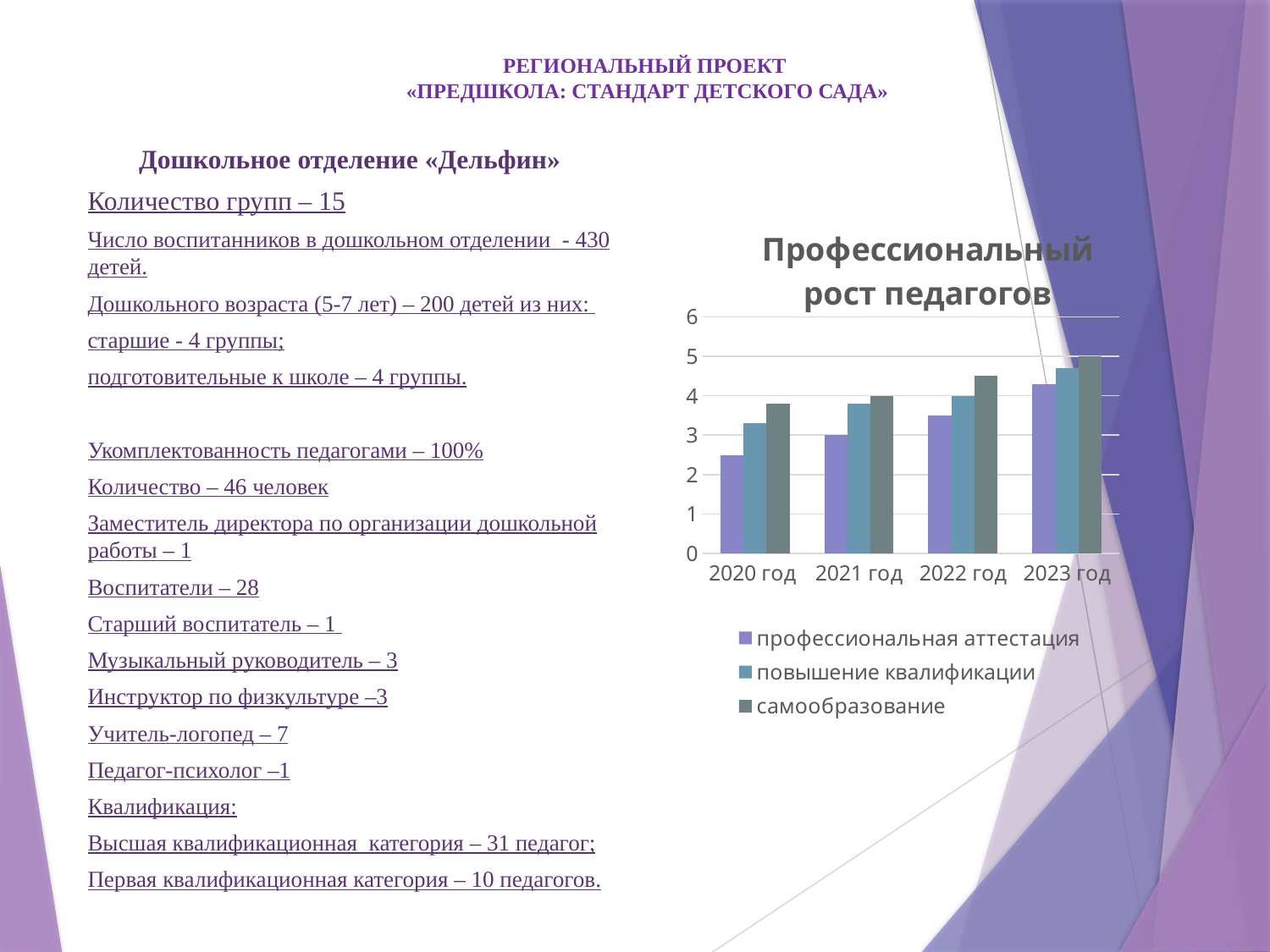
In the chart «Профессиональный рост педагогов», is the value for «профессиональная аттестация» in 2020 год greater or less than 3? less What type of chart is shown under the title «Профессиональный рост педагогов»? bar chart What is the title of the chart on the right side of the slide? Профессиональный рост педагогов In the chart «Профессиональный рост педагогов», does the value for «профессиональная аттестация» rise or fall from 2020 год to 2023 год? rise In the chart «Профессиональный рост педагогов», in which year is the «профессиональная аттестация» bar the lowest? 2020 год How many year categories are shown on the x axis of the chart «Профессиональный рост педагогов»? 4 In the chart «Профессиональный рост педагогов», is the value for «самообразование» in 2022 год greater or less than 4? greater In the chart «Профессиональный рост педагогов», is the value for «профессиональная аттестация» in 2023 год greater or less than 4? greater In the chart «Профессиональный рост педагогов», which is larger: «самообразование» in 2023 год or «профессиональная аттестация» in 2020 год? самообразование in 2023 год How many series does the legend of the chart «Профессиональный рост педагогов» list? 3 In the chart «Профессиональный рост педагогов», in which year is the «самообразование» bar the highest? 2023 год